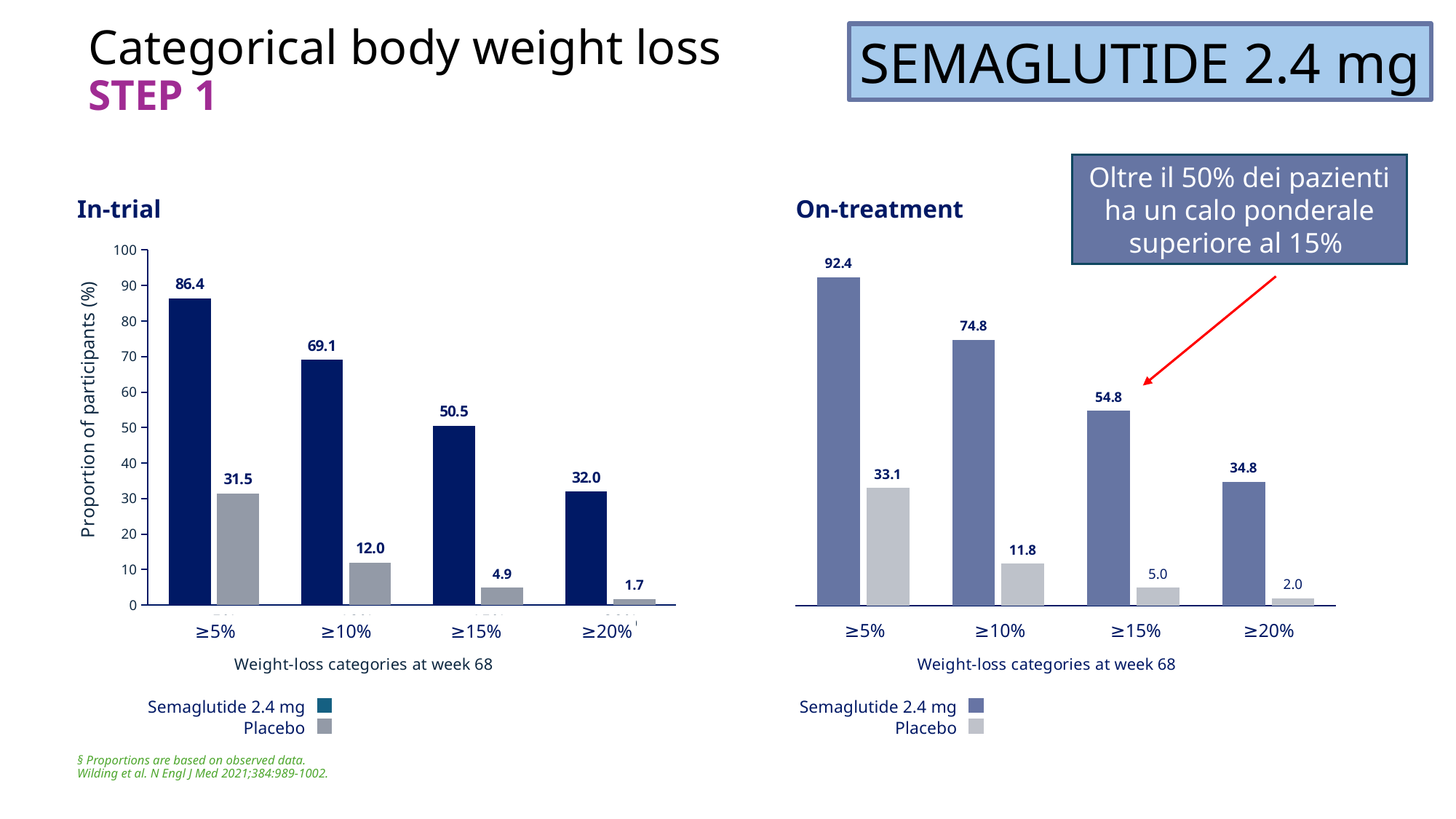
In the On-treatment chart, which weight-loss category has the highest Semaglutide 2.4 mg value? ≥5% In the On-treatment chart, what is the difference between the Semaglutide 2.4 mg values for ≥5% and ≥10%? 17.6 In the On-treatment chart, what is the value for Placebo in the ≥10% category? 11.8 In the In-trial chart, which weight-loss category has the lowest Placebo value? ≥20% In the On-treatment chart, do the Semaglutide 2.4 mg values rise or fall from ≥5% to ≥20%? Fall In the In-trial chart, what is the difference between Semaglutide 2.4 mg and Placebo in the ≥15% category? 45.6 What is the x-axis label of the On-treatment chart? Weight-loss categories at week 68 In the In-trial chart, what is the value for Semaglutide 2.4 mg in the ≥5% category? 86.4 Which is larger: the Semaglutide 2.4 mg value for ≥20% in the In-trial chart or in the On-treatment chart? On-treatment What kind of chart is the In-trial chart? Bar chart How many weight-loss categories are shown on the x axis of the In-trial chart? 4 How many series does the legend of the On-treatment chart list? 2